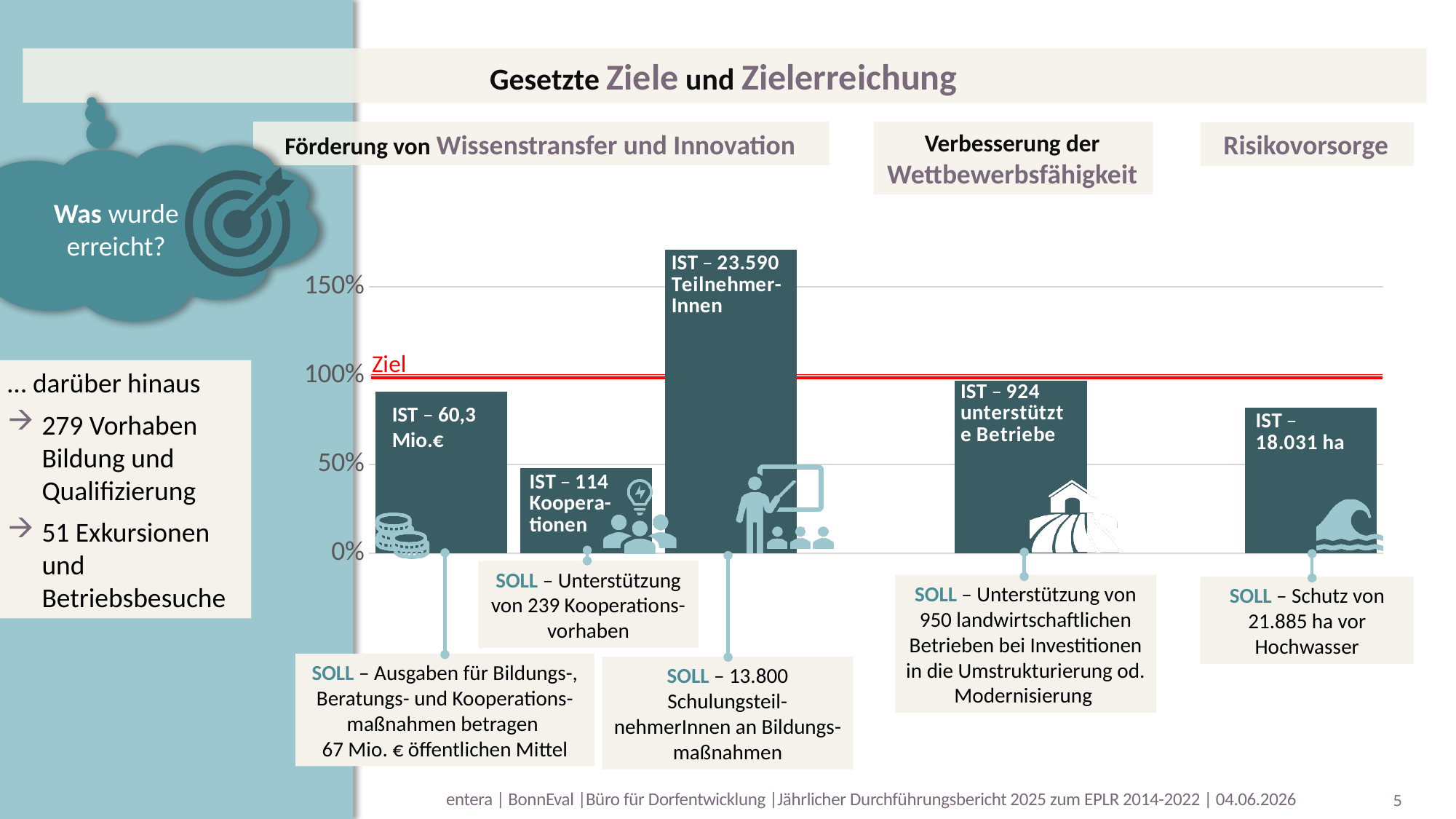
What IST value is printed on the first bar (Ausgaben für Bildungs-, Beratungs- und Kooperationsmaßnahmen)? 60,3 Mio.€ What IST value is printed on the bar for unterstützte Betriebe? 924 unterstützte Betriebe At what percentage level is the red 'Ziel' line drawn? 100% What IST value is printed on the bar for Schulungsteilnehmer an Bildungsmaßnahmen? 23.590 TeilnehmerInnen Which bar shows the lowest level of target achievement? IST – 114 Kooperationen What IST value is printed on the bar for Schutz vor Hochwasser? 18.031 ha Is the bar for 23.590 TeilnehmerInnen greater or less than 150%? greater What kind of chart is shown on the slide? bar chart How many bars does the chart contain? 5 Is the bar for 60,3 Mio.€ greater or less than 100%? less Which bar is taller: the one for 114 Kooperationen or the one for 18.031 ha? 18.031 ha Which bar reaches the highest level of target achievement? IST – 23.590 TeilnehmerInnen